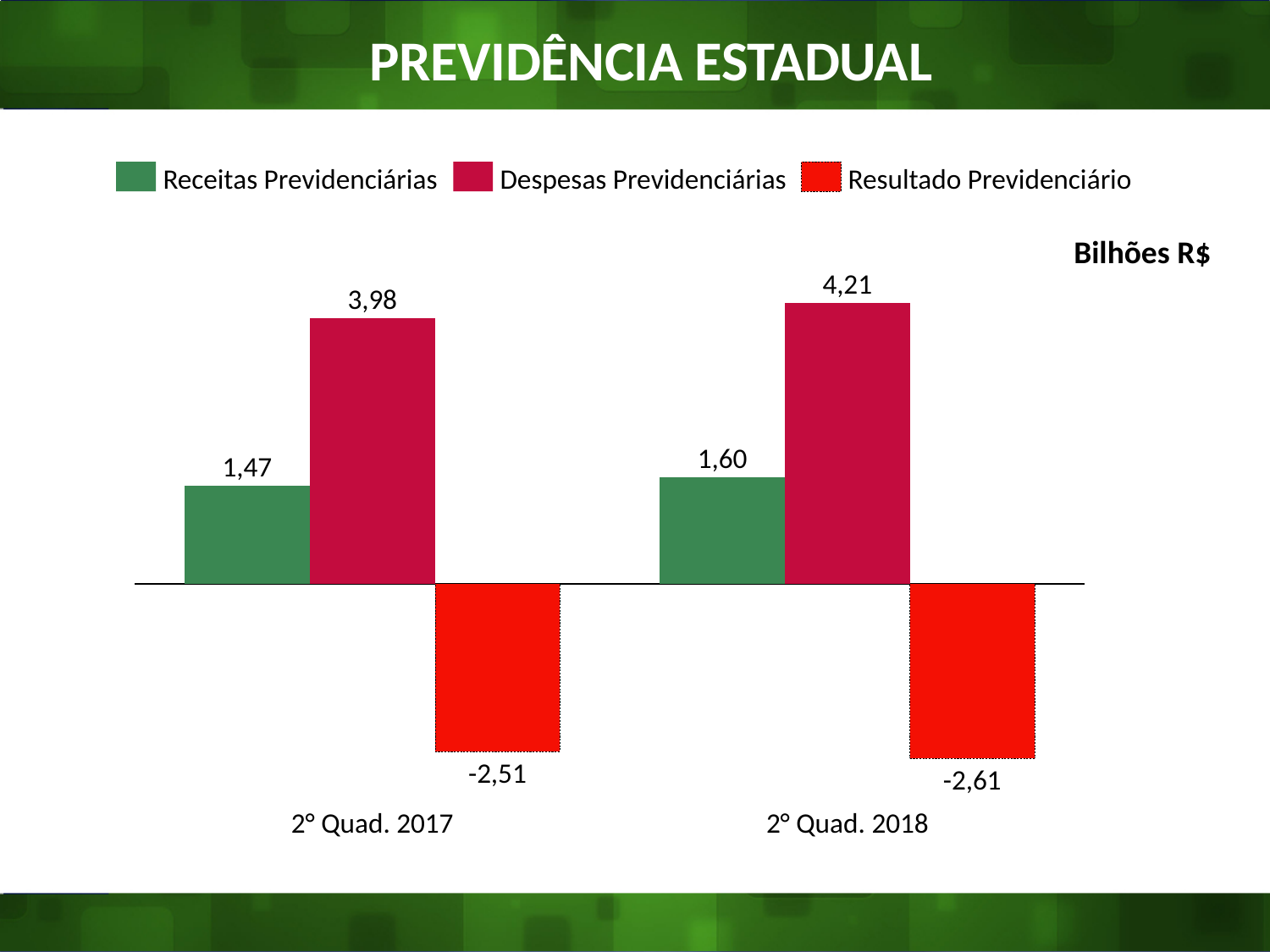
Which is larger: Receitas Previdenciárias in 2° Quad. 2017 or in 2° Quad. 2018? 2° Quad. 2018 What unit is indicated for the values in the chart? Bilhões R$ What is the value of Receitas Previdenciárias for 2° Quad. 2018? 1,60 What is the difference between Despesas Previdenciárias and Receitas Previdenciárias in 2° Quad. 2017? 2,51 What is the value of Despesas Previdenciárias for 2° Quad. 2018? 4,21 What kind of chart is shown on the slide? Bar chart Which category has the highest value for Despesas Previdenciárias? 2° Quad. 2018 Which category has the lowest value for Resultado Previdenciário? 2° Quad. 2018 How many series does the legend list? 3 How many categories are shown on the x axis? 2 What is the value of Resultado Previdenciário for 2° Quad. 2017? -2,51 What is the value of Receitas Previdenciárias for 2° Quad. 2017? 1,47